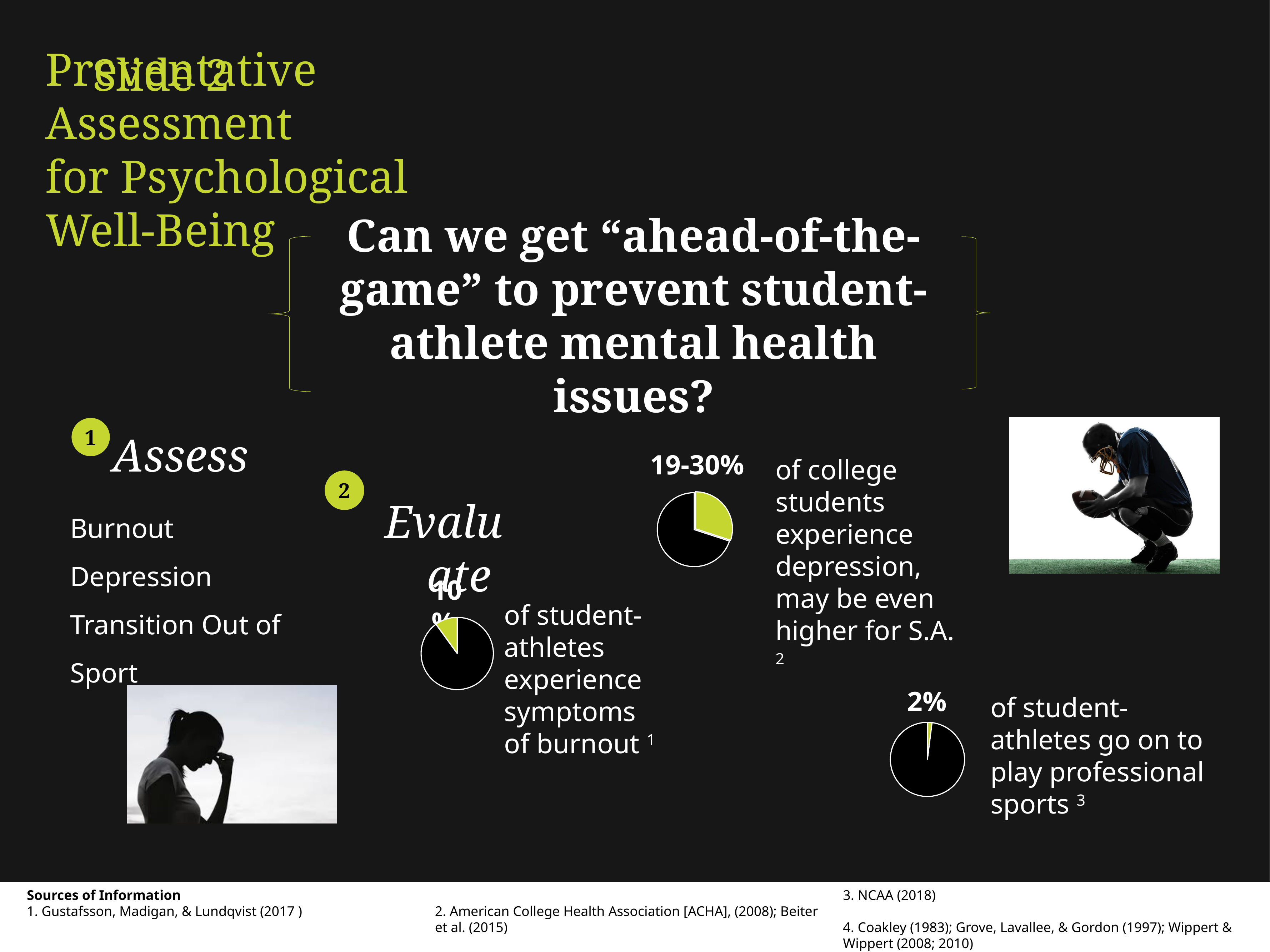
Which of the three pie charts shows the smallest highlighted share? Student-athletes who go on to play professional sports (2%) What kind of charts are used to show the statistics on the slide? Pie charts Which is larger: the share of college students who experience depression or the share of student-athletes who go on to play professional sports? College students who experience depression What is the difference between the percentage of student-athletes experiencing burnout symptoms and the percentage who go on to play professional sports? 8% According to the pie chart at the bottom right, what percentage of student-athletes go on to play professional sports? 2% How many pie charts are shown on the slide? 3 What colour is used for the highlighted slice in each pie chart? Yellow-green According to the pie chart next to 'Evaluate', what percentage of student-athletes experience symptoms of burnout? 10% Which of the three pie charts shows the largest highlighted share? College students experiencing depression (19-30%) Which source number is cited for the 2% professional sports statistic? 3 According to the pie chart in the upper middle, what percentage of college students experience depression? 19-30%